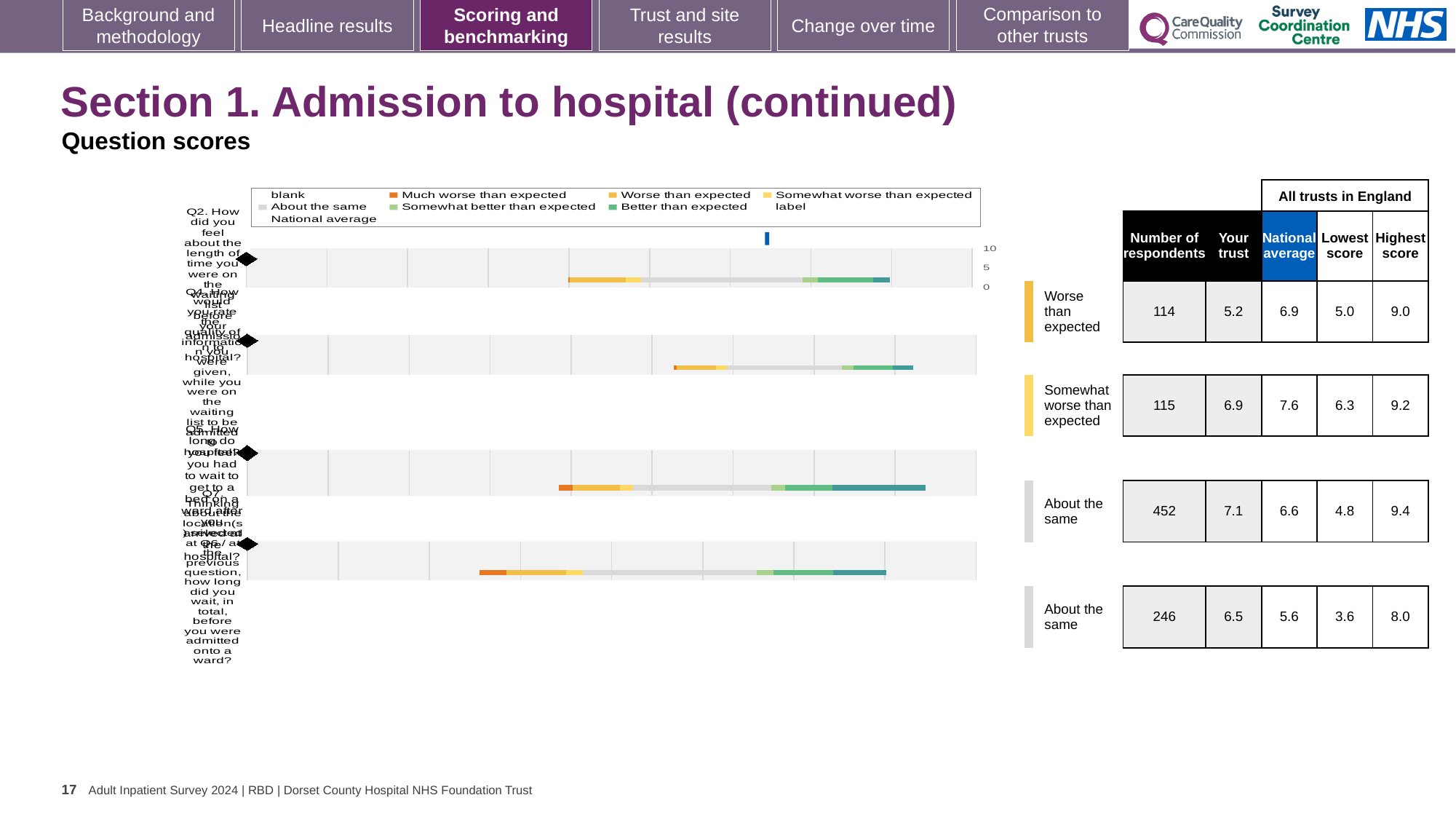
How many rows of scores does the table contain? 4 In the table's 'Worse than expected' row, which is larger: the 'Your trust' score or the national average? National average In the table, what is the difference between the highest score and the lowest score for the row rated 'Worse than expected'? 4.0 In the table, what is the 'Your trust' score for the row rated 'Somewhat worse than expected'? 6.9 In the table, what is the largest value in the 'Highest score' column? 9.4 In the table, what is the national average for the row with 452 respondents? 6.6 In the table, what is the number of respondents for the row rated 'Worse than expected'? 114 What is the heading above the 'National average', 'Lowest score' and 'Highest score' columns of the table? All trusts in England In the table, what is the lowest value in the 'Lowest score' column? 3.6 What kind of chart is shown on the left of the slide? bar chart How many entries does the chart legend list? 9 In the table, what is the highest number of respondents shown in any row? 452